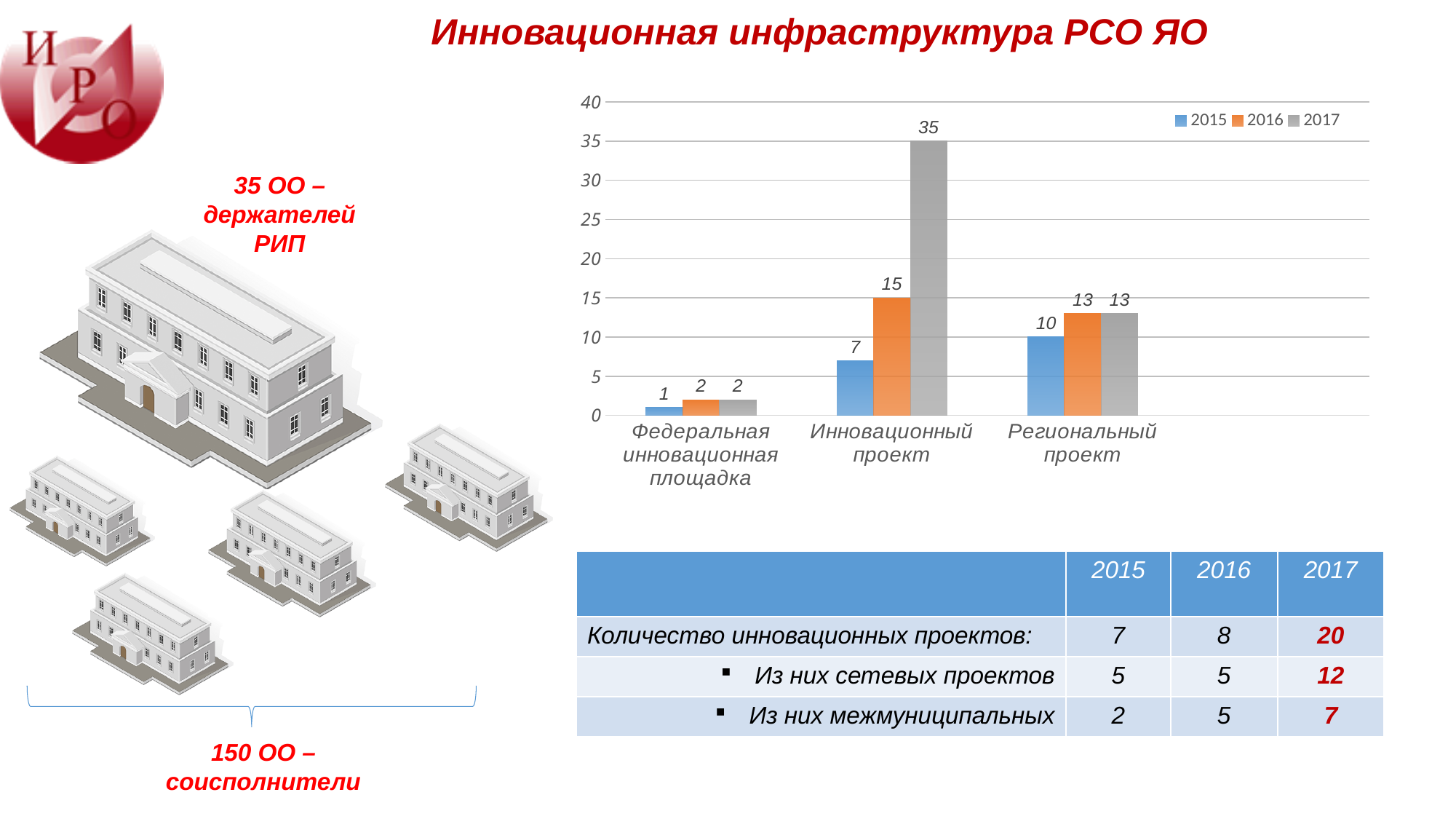
What kind of chart is shown on the slide? bar chart What is the difference between the 2017 and 2016 values for Инновационный проект? 20 How many series does the chart legend list? 3 Which category has the highest value in 2017? Инновационный проект Which category has the lowest value in 2015? Федеральная инновационная площадка What is the value for Инновационный проект in 2017? 35 How many categories are shown on the x axis of the chart? 3 Which is larger: the 2015 value for Региональный проект or the 2015 value for Инновационный проект? Региональный проект Do the values for Инновационный проект rise or fall from 2015 to 2017? rise What is the value for Региональный проект in 2016? 13 Which colour represents the 2016 series in the chart? orange What is the value for Федеральная инновационная площадка in 2015? 1